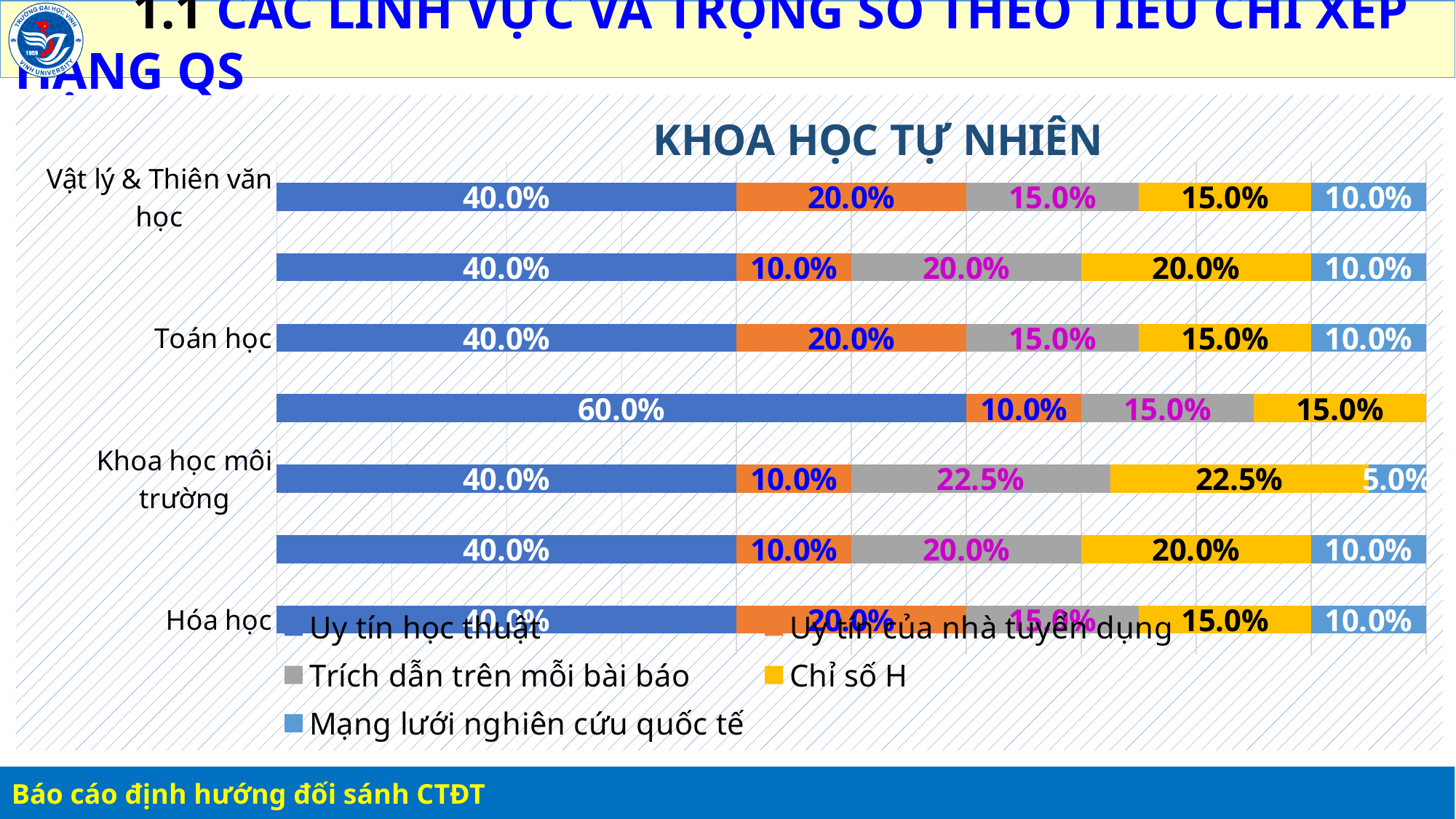
What kind of chart is shown on the slide? Stacked bar chart For Khoa học môi trường, which series has the lowest value? Mạng lưới nghiên cứu quốc tế For Vật lý & Thiên văn học, what is the difference between Uy tín học thuật and Uy tín của nhà tuyển dụng? 20.0% What is the value of Chỉ số H for Hóa học? 15.0% What is the title of the chart? KHOA HỌC TỰ NHIÊN For Toán học, which series has the highest value? Uy tín học thuật What is the value of Chỉ số H for Khoa học môi trường? 22.5% What is the value of Mạng lưới nghiên cứu quốc tế for Khoa học môi trường? 5.0% What is the value of Uy tín học thuật for Toán học? 40.0% For Khoa học môi trường, which is larger: Trích dẫn trên mỗi bài báo or Uy tín của nhà tuyển dụng? Trích dẫn trên mỗi bài báo How many series does the legend list? 5 What is the value of Uy tín của nhà tuyển dụng for Vật lý & Thiên văn học? 20.0%